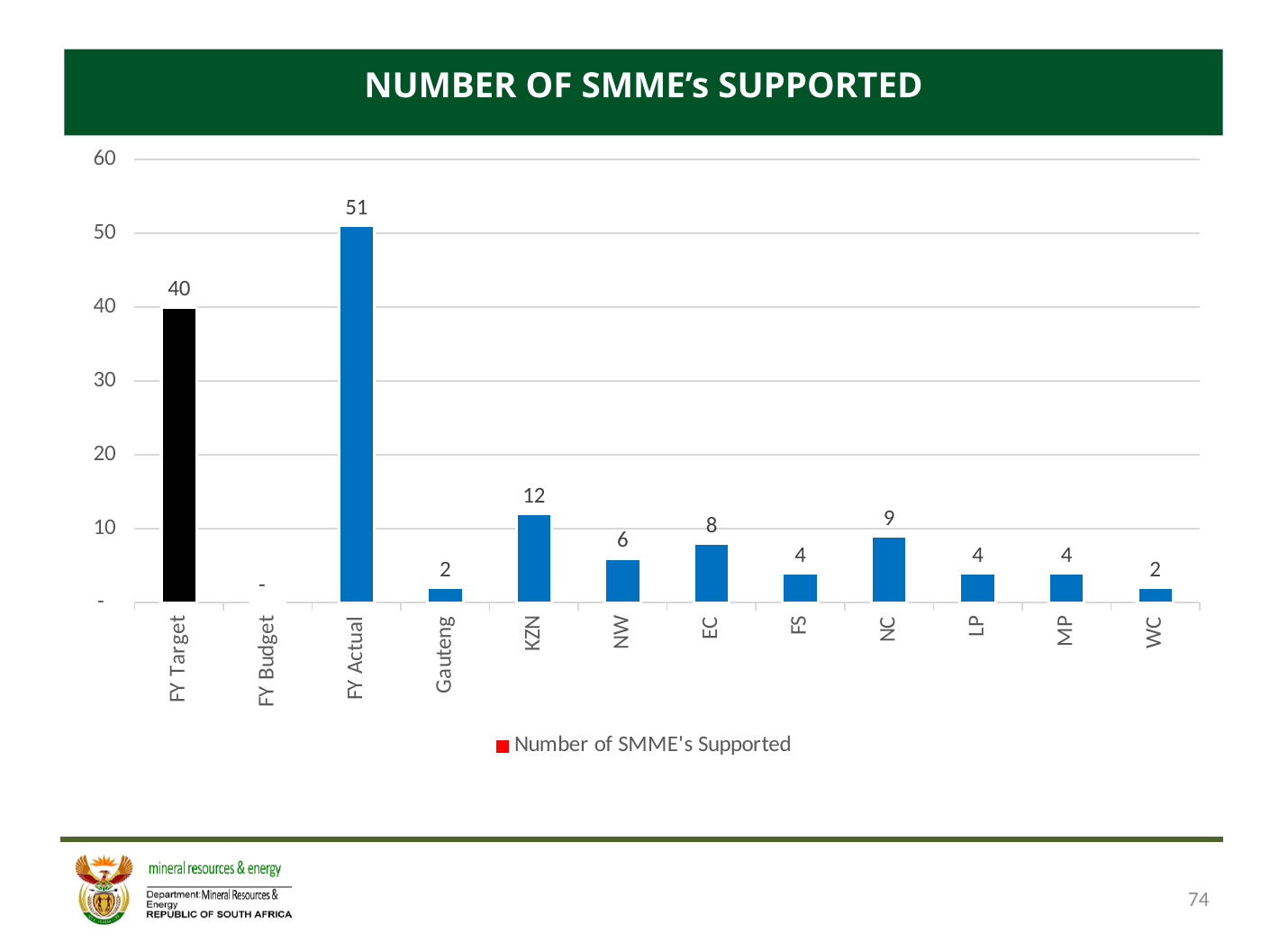
How many series does the legend list? 1 Is the value for FY Target greater or less than 30? greater Which category has the highest value? FY Actual Which province has the highest number of SMME's supported? KZN What is the title of the chart? NUMBER OF SMME's SUPPORTED What is the value for NC? 9 What kind of chart is shown? bar chart What is the difference between FY Actual and FY Target? 11 How many categories are shown on the x axis? 12 Which is larger, the value for EC or the value for NW? EC What is the value for FY Actual? 51 What is the value for KZN? 12